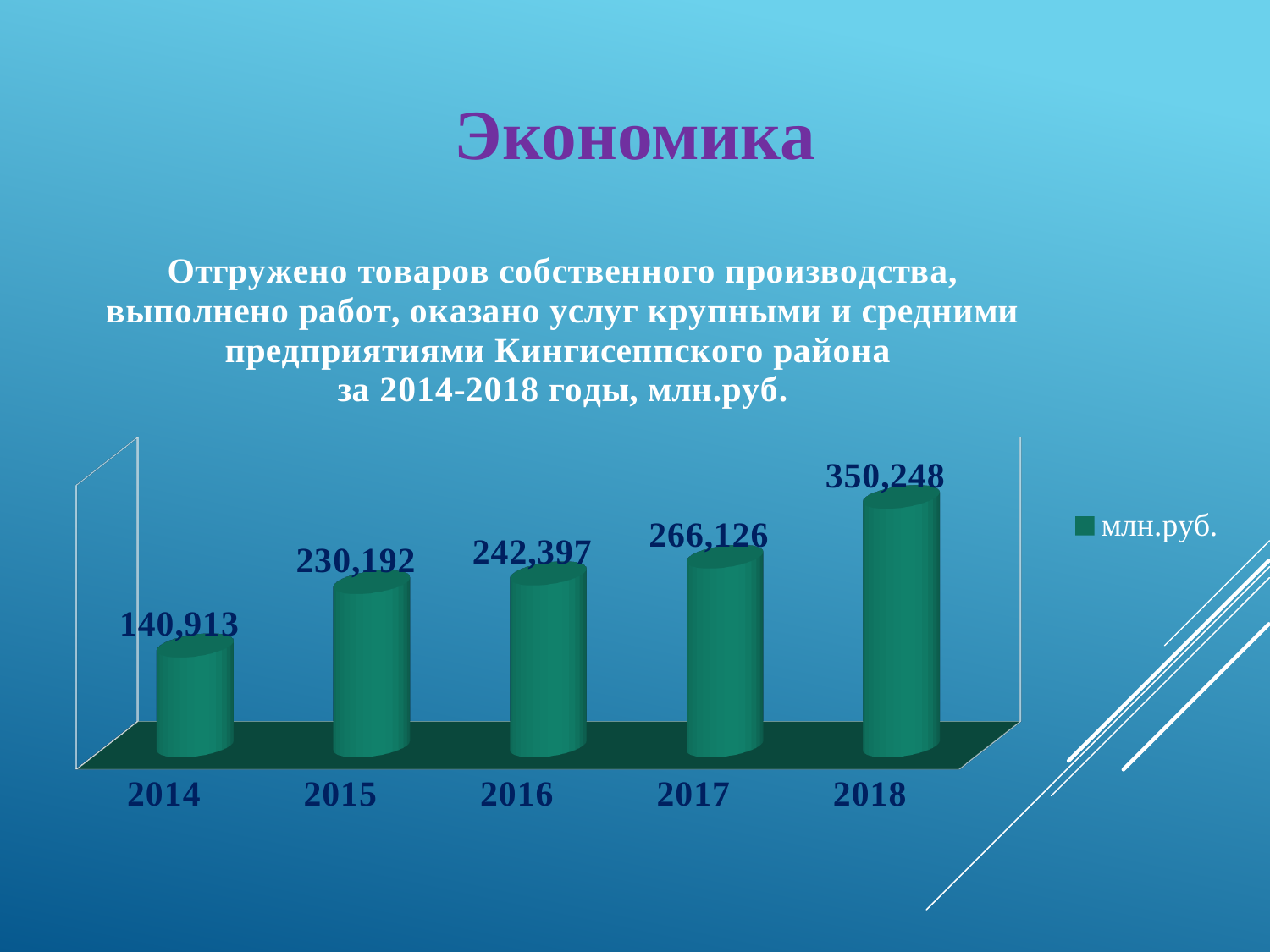
Do the values rise or fall from 2014 to 2018? rise What is the difference between the values for 2017 and 2016? 23,729 Which is larger, the value for 2015 or the value for 2017? 2017 What is the value for 2016? 242,397 What kind of chart is shown? bar chart Which year has the lowest value? 2014 How many series does the legend list? 1 What is the difference between the values for 2018 and 2014? 209,335 What is the value for 2014? 140,913 Which year has the highest value? 2018 How many years are shown on the x axis? 5 What is the value for 2018? 350,248